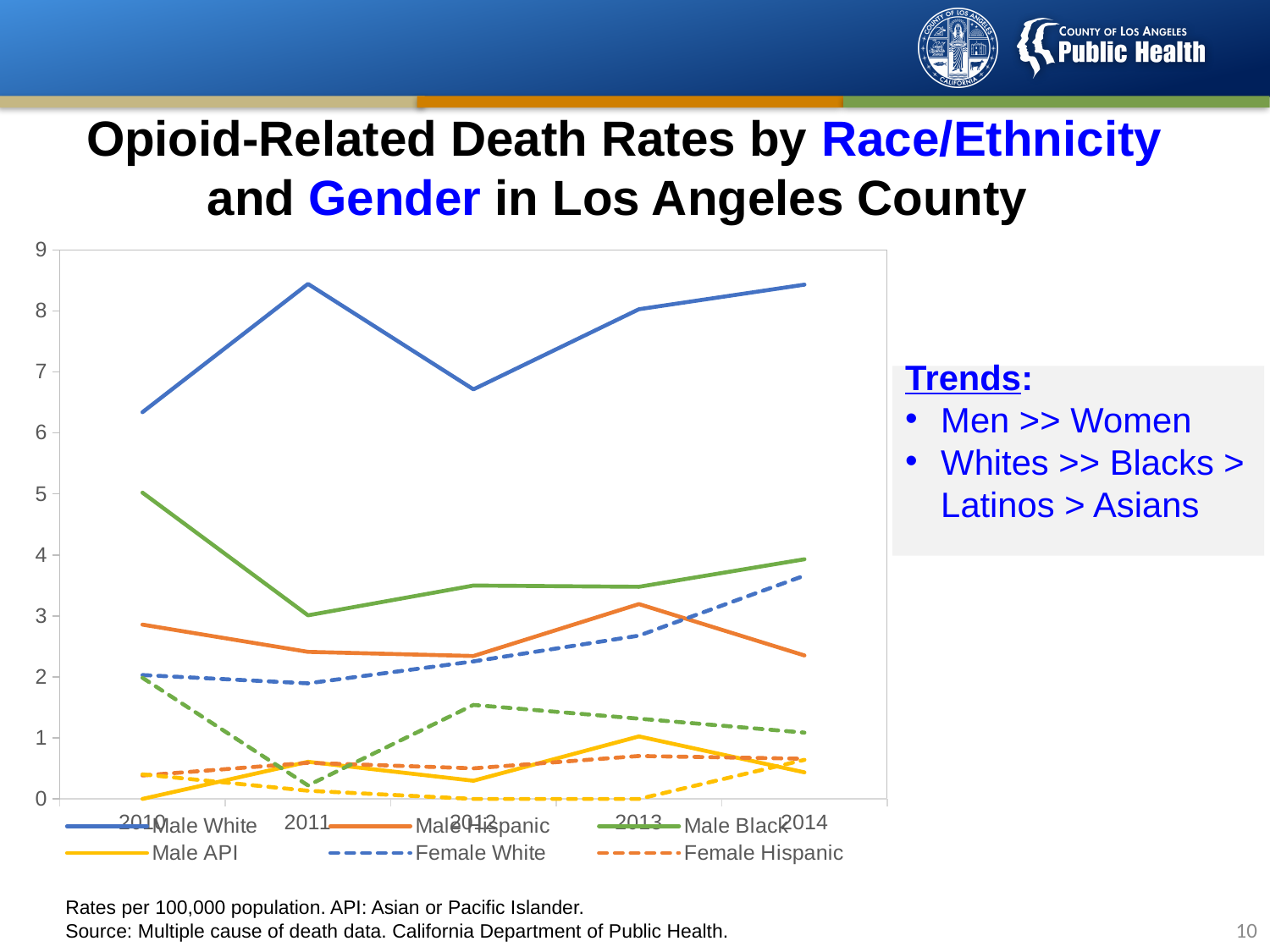
Is the value for Female White in 2014 greater or less than 3? greater Does the Female White rate rise or fall from 2010 to 2014? rise How many years are plotted along the x axis? 5 Is the value for Male White in 2011 greater or less than 8? greater How many series does the legend list? 6 Is the value for Male Black in 2010 greater or less than 4? greater In which year is the Male Black rate highest? 2010 What kind of chart is shown on the slide? line chart In which year is the Male White rate lowest? 2010 Which series has the highest value in 2014? Male White In 2014, which is larger: Female White or Male Hispanic? Female White